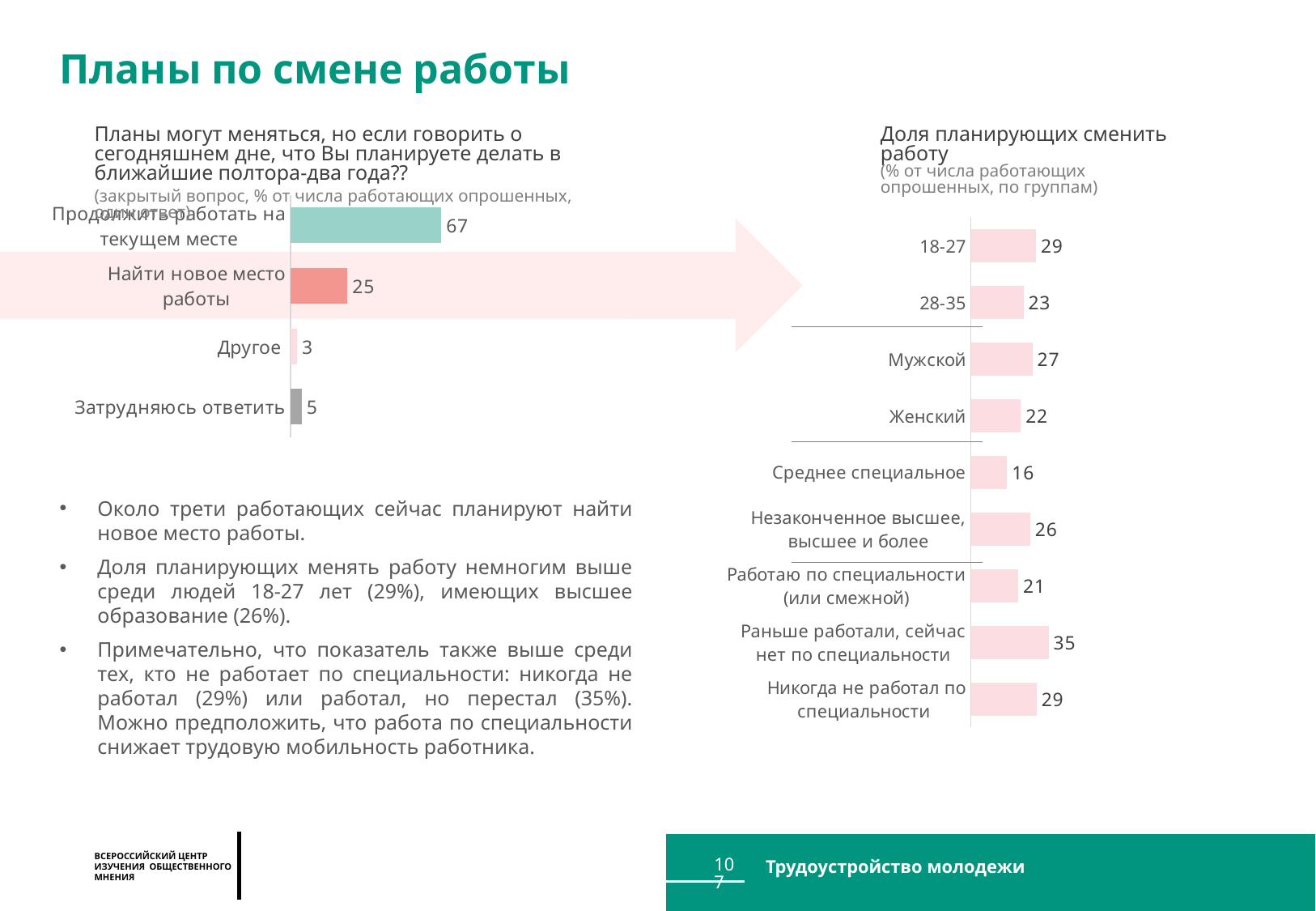
In the chart «Доля планирующих сменить работу», which group has the highest value? Раньше работали, сейчас нет по специальности What type of chart is the left chart? bar chart In the left chart, which category has the lowest value? Другое In the chart «Доля планирующих сменить работу», which is larger: «Мужской» or «Женский»? Мужской How many groups does the chart «Доля планирующих сменить работу» show? 9 In the chart «Доля планирующих сменить работу», which group has the lowest value? Среднее специальное How many categories does the left chart show? 4 In the chart «Доля планирующих сменить работу», what is the value for «18-27»? 29 In the left chart, what is the value for «Найти новое место работы»? 25 In the chart «Доля планирующих сменить работу», what is the value for «Женский»? 22 In the left chart, what is the difference between «Продолжить работать на текущем месте» and «Найти новое место работы»? 42 In the left chart, what is the value for «Продолжить работать на текущем месте»? 67